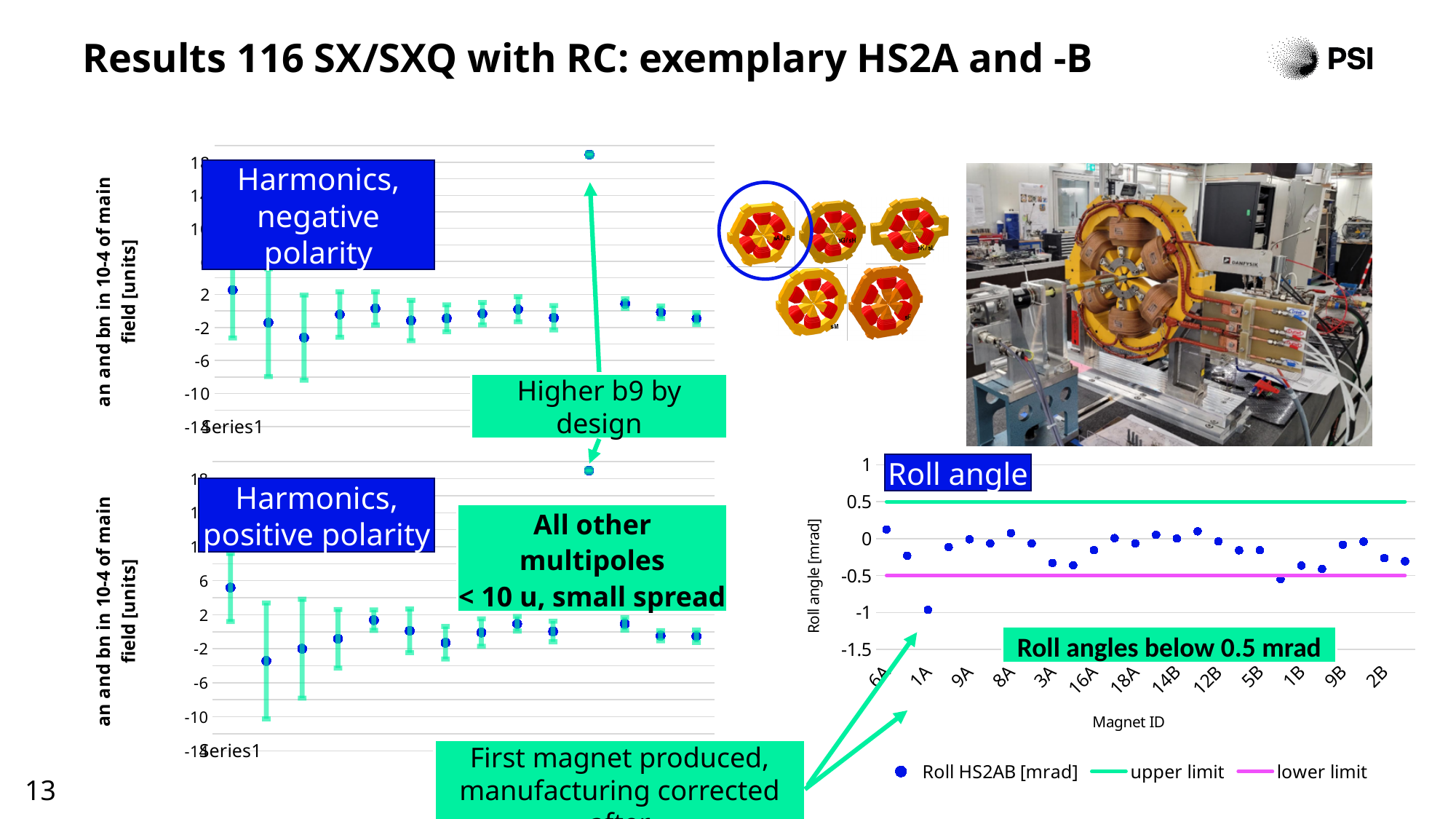
What kind of chart is the Roll angle chart? scatter chart On the Roll angle chart, what value does the lower limit line sit at? -0.5 On the Roll angle chart, which has the larger roll angle, magnet 6A or magnet 1A? 6A How many series does the legend of the Roll angle chart list? 3 On the 'Harmonics, positive polarity' chart, is the highest plotted point greater or less than 14? greater On the Roll angle chart, is the roll angle for magnet 6A greater or less than 0? greater What legend entry is shown on the 'Harmonics, positive polarity' chart? Series1 On the Roll angle chart, is the roll angle for magnet 1A greater or less than -0.5? less On the Roll angle chart, which magnet ID has the lowest roll angle? 1A On the Roll angle chart, what value does the upper limit line sit at? 0.5 What is the x-axis title of the Roll angle chart? Magnet ID